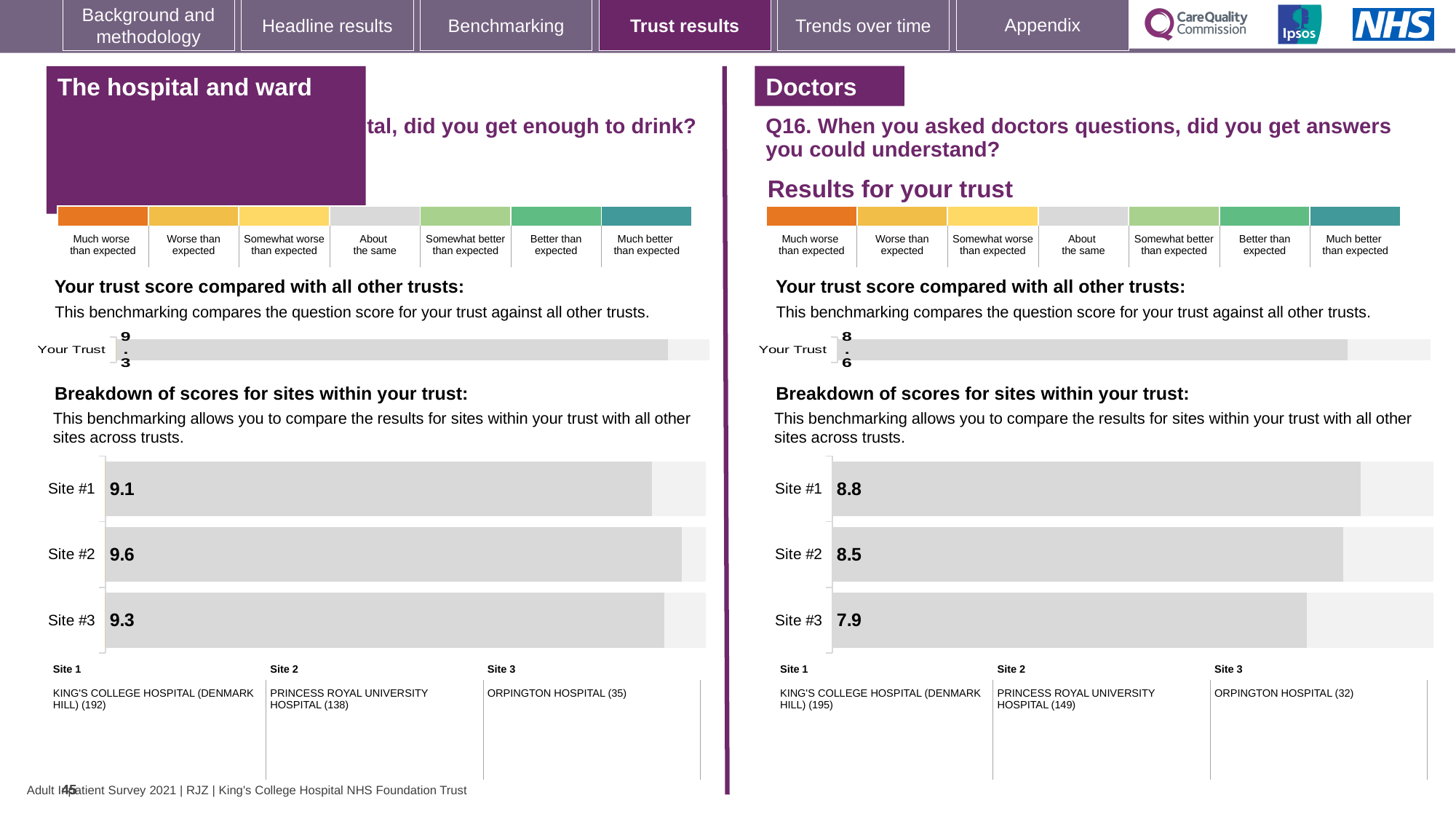
In the right-hand (Q16) site breakdown chart, do the scores rise or fall going from Site #1 to Site #3? Fall In the left-hand 'Breakdown of scores for sites within your trust' chart, what is the score for Site #2? 9.6 In the right-hand (Q16, Doctors) 'Your trust score compared with all other trusts' chart, what is the score for Your Trust? 8.6 In the left-hand site breakdown chart, which has the higher score, Site #1 or Site #3? Site #3 In the left-hand site breakdown chart, which site has the highest score? Site #2 In the right-hand (Q16) site breakdown chart, which site has the lowest score? Site #3 In the left-hand 'Your trust score compared with all other trusts' chart, what is the score for Your Trust? 9.3 How many sites are shown in the right-hand (Q16) site breakdown chart? 3 In the left-hand site breakdown chart, how much higher is the score for Site #2 than for Site #1? 0.5 What kind of chart is used for the site breakdown on the left-hand side of the slide? Bar chart In the right-hand (Q16, Doctors) 'Breakdown of scores for sites within your trust' chart, what is the score for Site #3? 7.9 In the right-hand (Q16) site breakdown chart, what is the difference between the scores for Site #1 and Site #3? 0.9